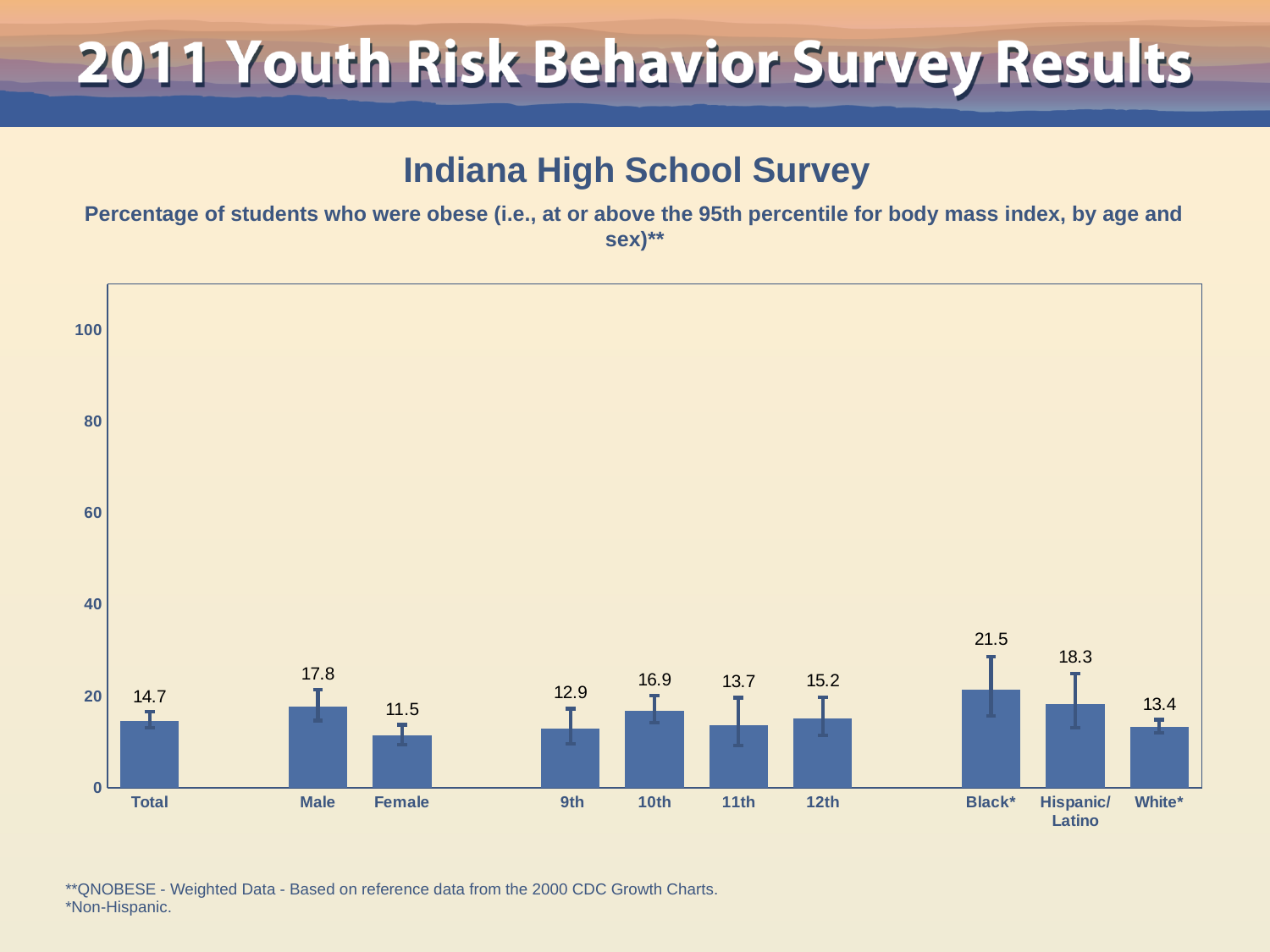
What is the value for Hispanic/Latino? 18.3 What is the value for Total? 14.7 What is the difference between the values for Male and Female? 6.3 Which category has the lowest value? Female Which category has the highest value? Black* What is the difference between the values for Black* and White*? 8.1 How many categories are shown on the x axis? 10 Is the value for Black* greater or less than 20? greater What kind of chart is this? bar chart What is the value for Male? 17.8 What is the title of the survey shown above the chart? Indiana High School Survey Which is larger, the value for 10th or the value for 11th? 10th